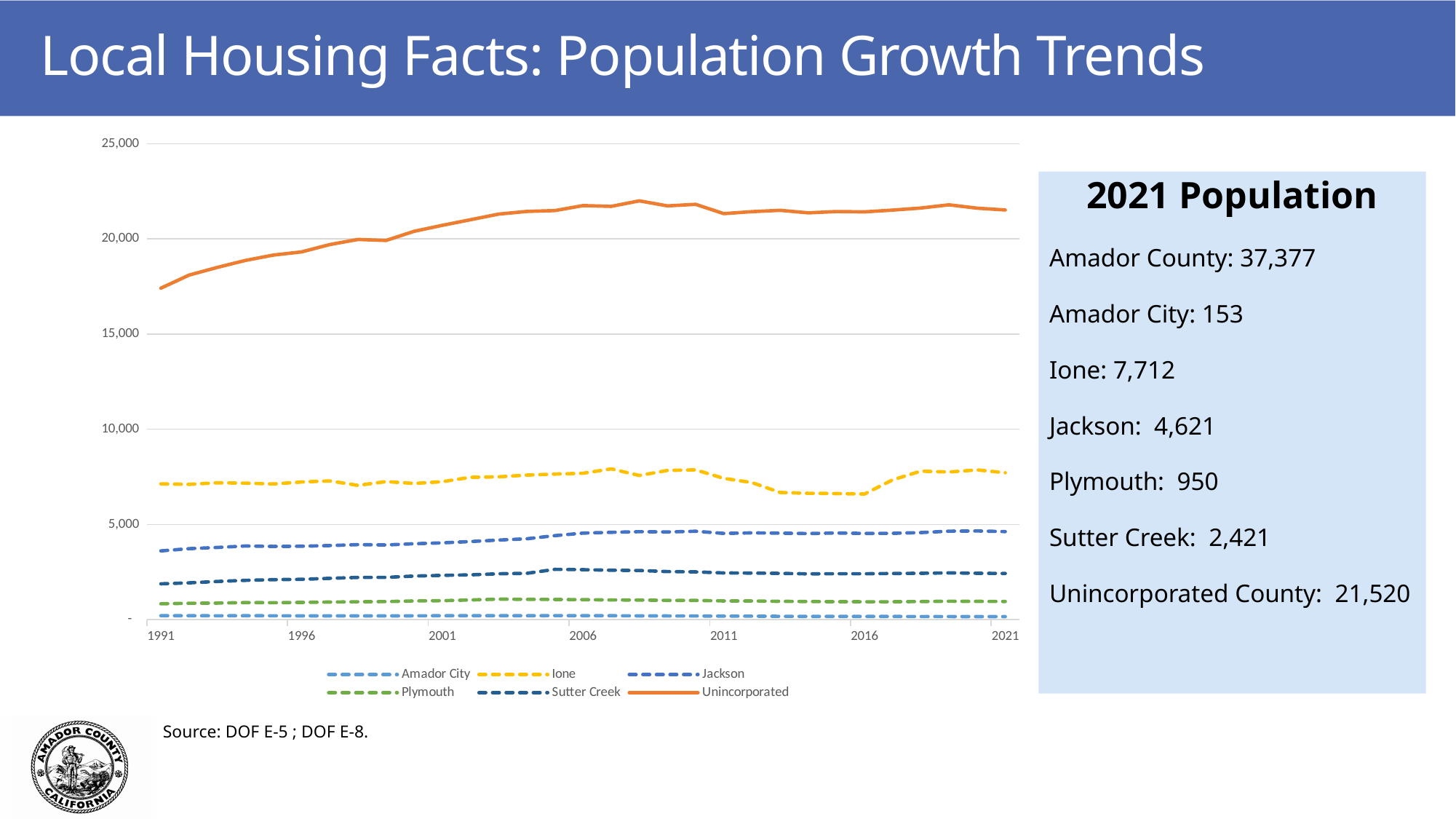
Which has the larger 2021 population, Jackson or Sutter Creek? Jackson How many series does the chart legend list? 6 Which series has the lowest population in 2021? Amador City Which series is drawn as a solid orange line rather than a dashed line? Unincorporated How many year labels are shown on the x axis? 7 What is the 2021 population of the Unincorporated County? 21,520 What is the difference between the 2021 populations of Ione and Jackson? 3,091 What kind of chart is shown on the slide? line chart Is the Unincorporated population in 1991 greater or less than 20,000? less Does the Unincorporated population rise or fall overall from 1991 to 2021? rise Which series has the highest population in 2021? Unincorporated What is the 2021 population of Ione? 7,712